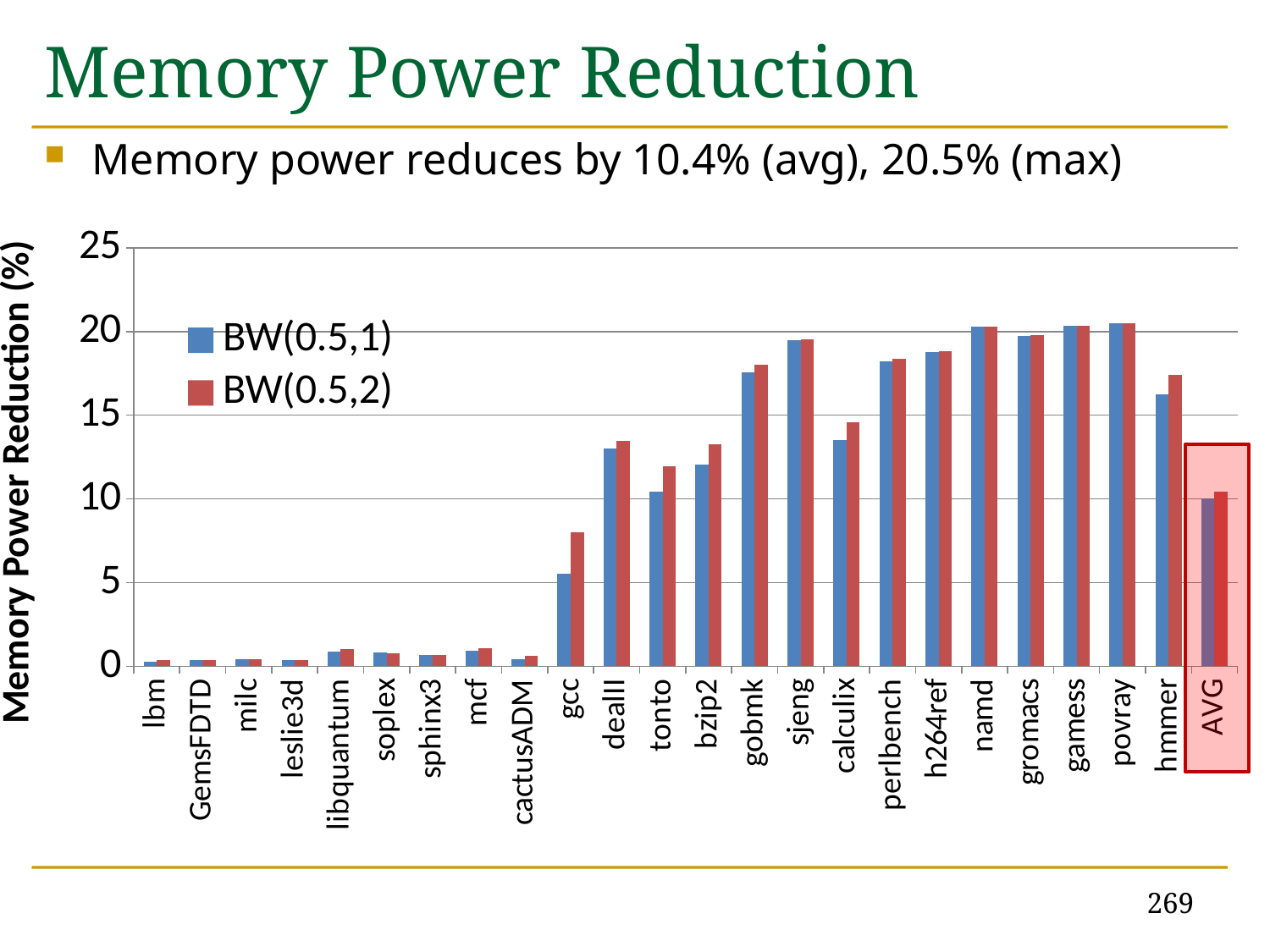
How many categories are shown along the x axis? 24 What are the two series named in the legend? BW(0.5,1) and BW(0.5,2) What kind of chart is shown on the slide? bar chart For gcc, which series has the larger value, BW(0.5,1) or BW(0.5,2)? BW(0.5,2) Is the BW(0.5,1) value for calculix greater or less than 10? greater Which has the larger BW(0.5,1) value, gcc or sjeng? sjeng Is the BW(0.5,2) value for sjeng greater or less than 15? greater What is the label of the y axis? Memory Power Reduction (%) How many series does the legend list? 2 Is the BW(0.5,1) value for gcc greater or less than 10? less